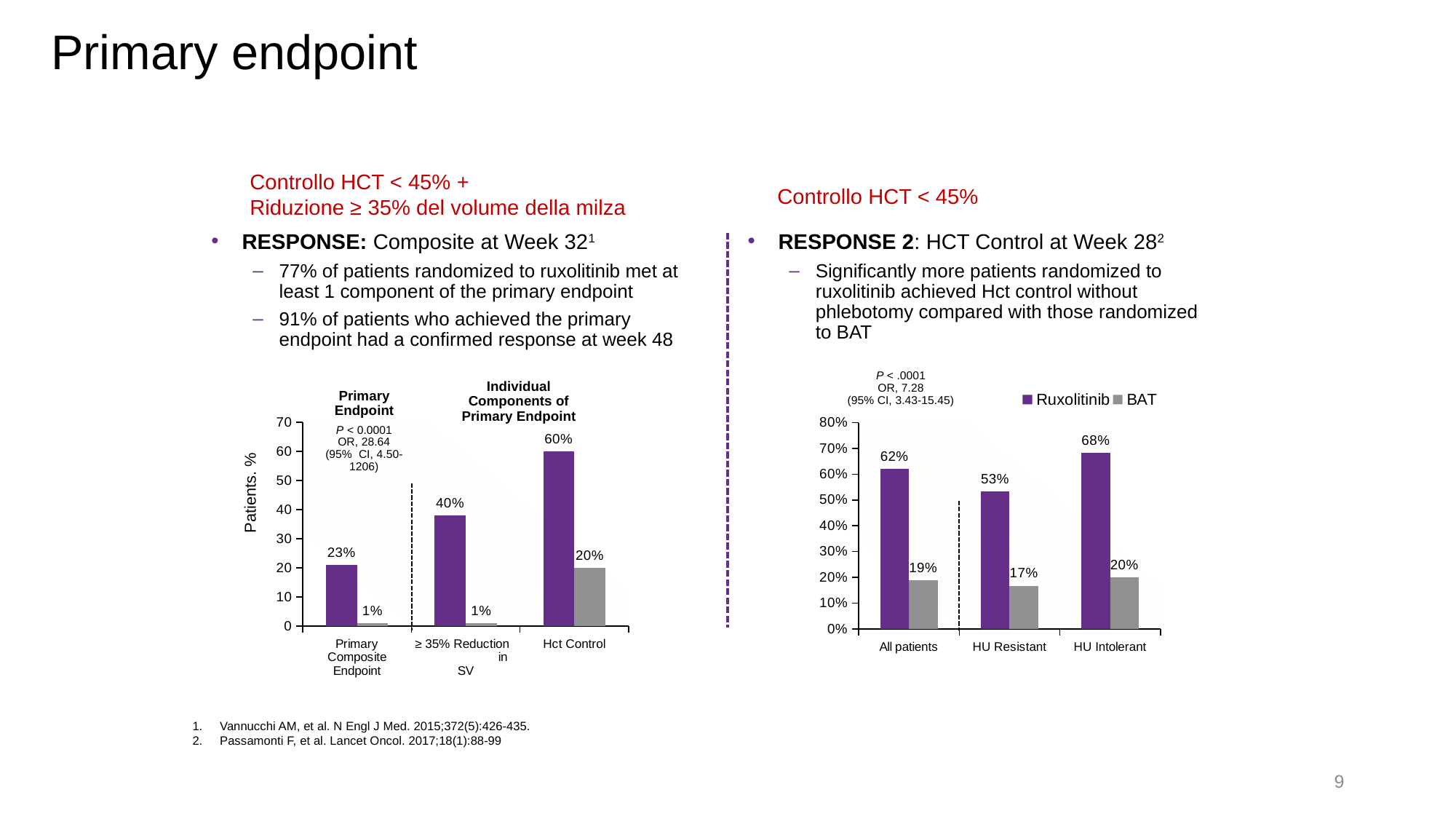
In the left chart (RESPONSE), what is the value of the gray bar for Primary Composite Endpoint? 1% In the right chart (RESPONSE 2), how many series does the legend list? 2 In the right chart (RESPONSE 2), what is the difference between Ruxolitinib and BAT for All patients? 43% In the right chart (RESPONSE 2), which is larger: the BAT value for All patients or the BAT value for HU Resistant? All patients In the left chart (RESPONSE), which category has the highest purple bar? Hct Control What kind of chart is the right chart (RESPONSE 2)? Bar chart In the left chart (RESPONSE), what is the difference between the purple and gray bars for Hct Control? 40% In the right chart (RESPONSE 2), what is the BAT value for HU Resistant? 17% In the right chart (RESPONSE 2), what is the Ruxolitinib value for HU Intolerant? 68% In the right chart (RESPONSE 2), which category has the lowest Ruxolitinib value? HU Resistant In the left chart (RESPONSE), what is the value of the purple bar for Hct Control? 60% In the left chart (RESPONSE), how many categories are shown on the x axis? 3